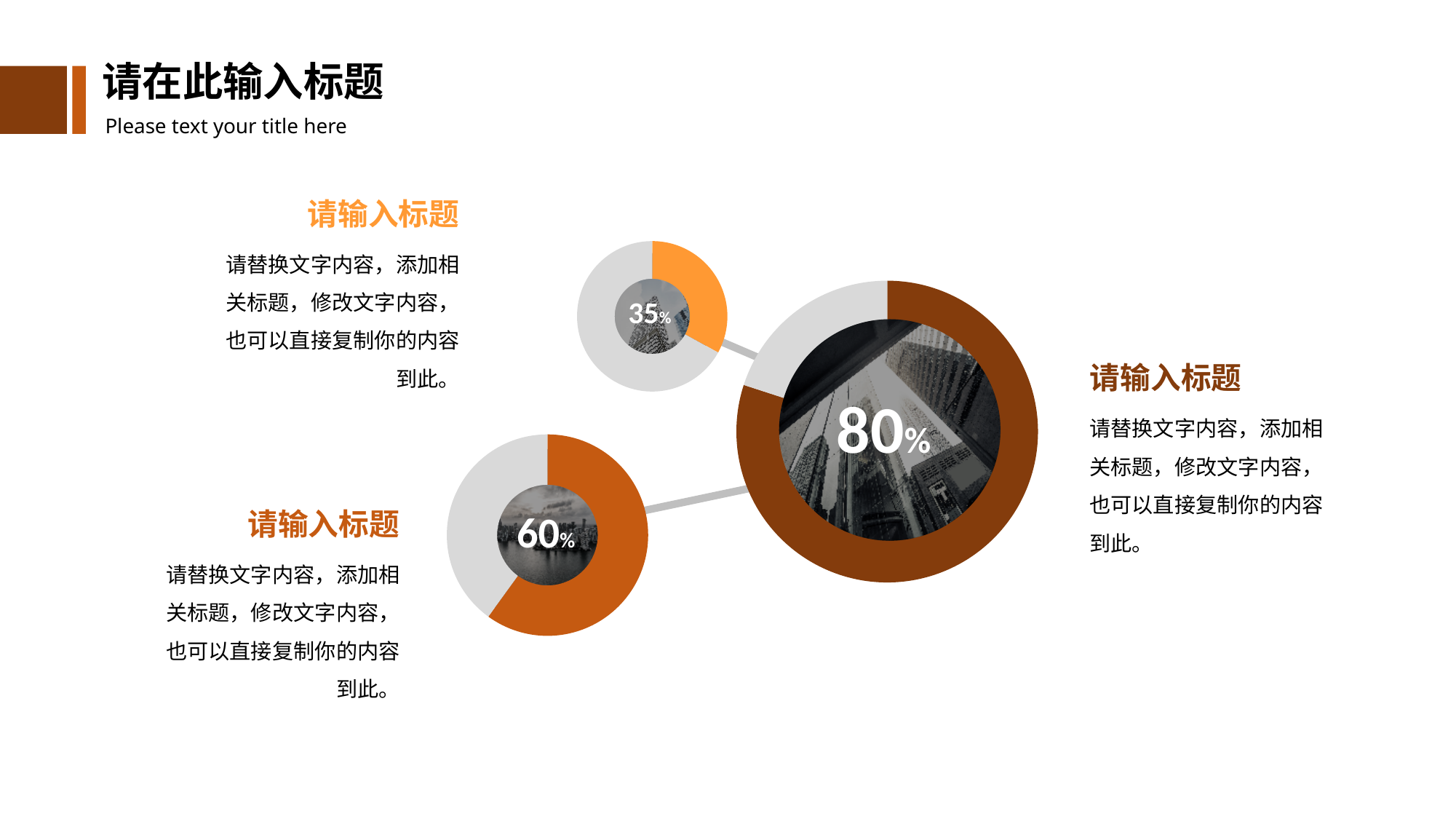
How many donut charts are shown on the slide? 3 Which is larger, the value in the top-left donut chart or the value in the bottom-left donut chart? The bottom-left donut chart (60%) What is the difference between the value in the large right donut chart and the value in the bottom-left donut chart? 20% What value is shown in the large donut chart on the right? 80% What colour is the filled portion of the large donut chart showing 80%? Brown What is the difference between the value in the bottom-left donut chart and the value in the top-left donut chart? 25% Which donut chart shows the highest percentage? The large one on the right (80%) What kind of chart is used to display the percentages on the slide? Donut chart What colour is the filled portion of the small donut chart showing 35%? Orange What value is shown in the small donut chart at the top left of the diagram? 35% Which donut chart shows the lowest percentage? The small one at the top left (35%) What value is shown in the donut chart at the bottom left of the diagram? 60%